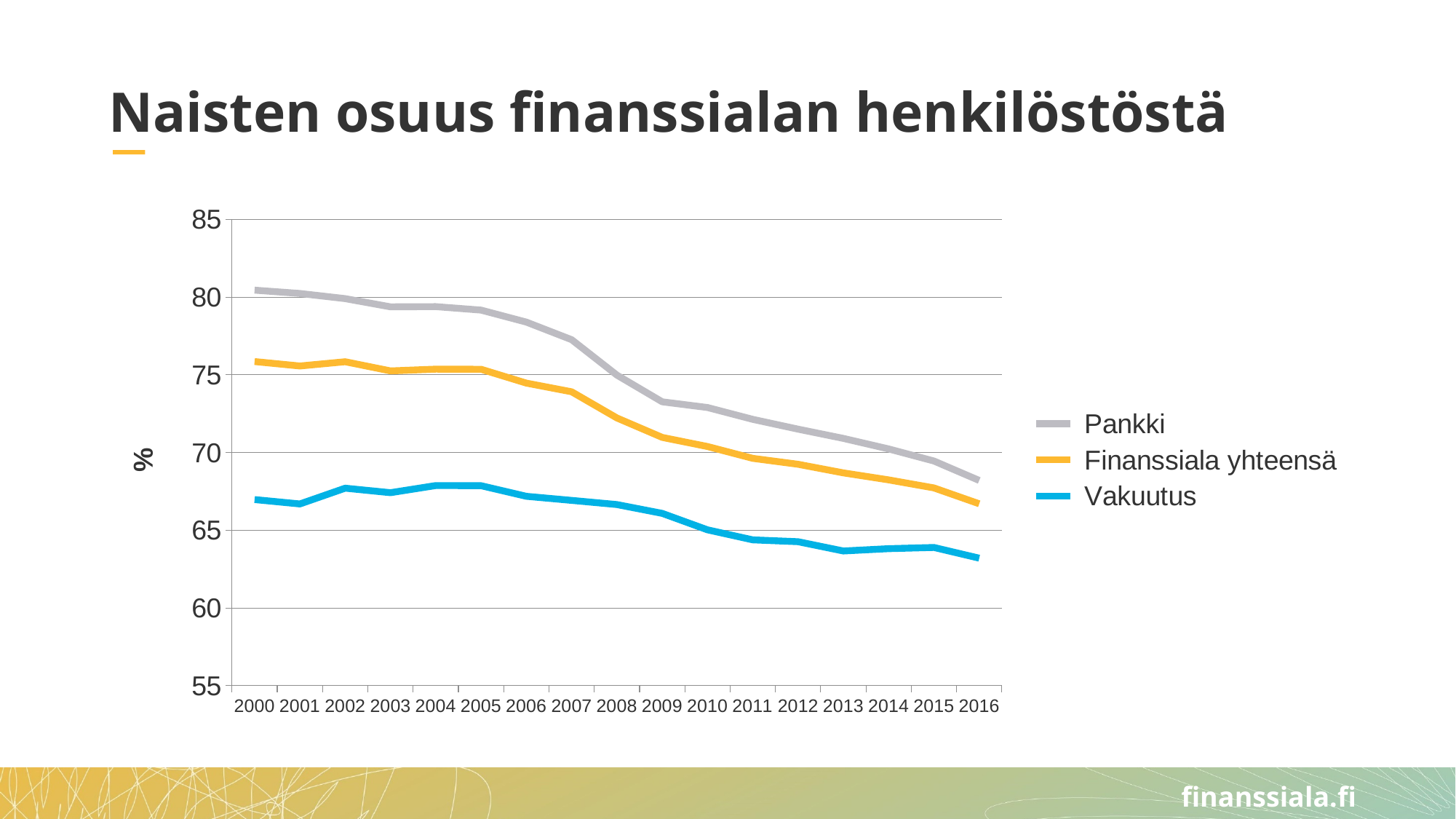
Which series has the lowest value in 2000? Vakuutus What kind of chart is shown on the slide? line chart Is the value for Pankki in 2016 greater or less than 70? less Which series has the highest value in 2016? Pankki Which series is drawn in blue? Vakuutus How many years are shown along the x axis? 17 Is the value for Vakuutus in 2016 greater or less than 65? less Does the Pankki series rise or fall from 2000 to 2016? fall How many series does the legend list? 3 In 2010, which is larger: the value for Pankki or the value for Vakuutus? Pankki What is the title of the chart? Naisten osuus finanssialan henkilöstöstä Is the value for Pankki in 2009 greater or less than 70? greater